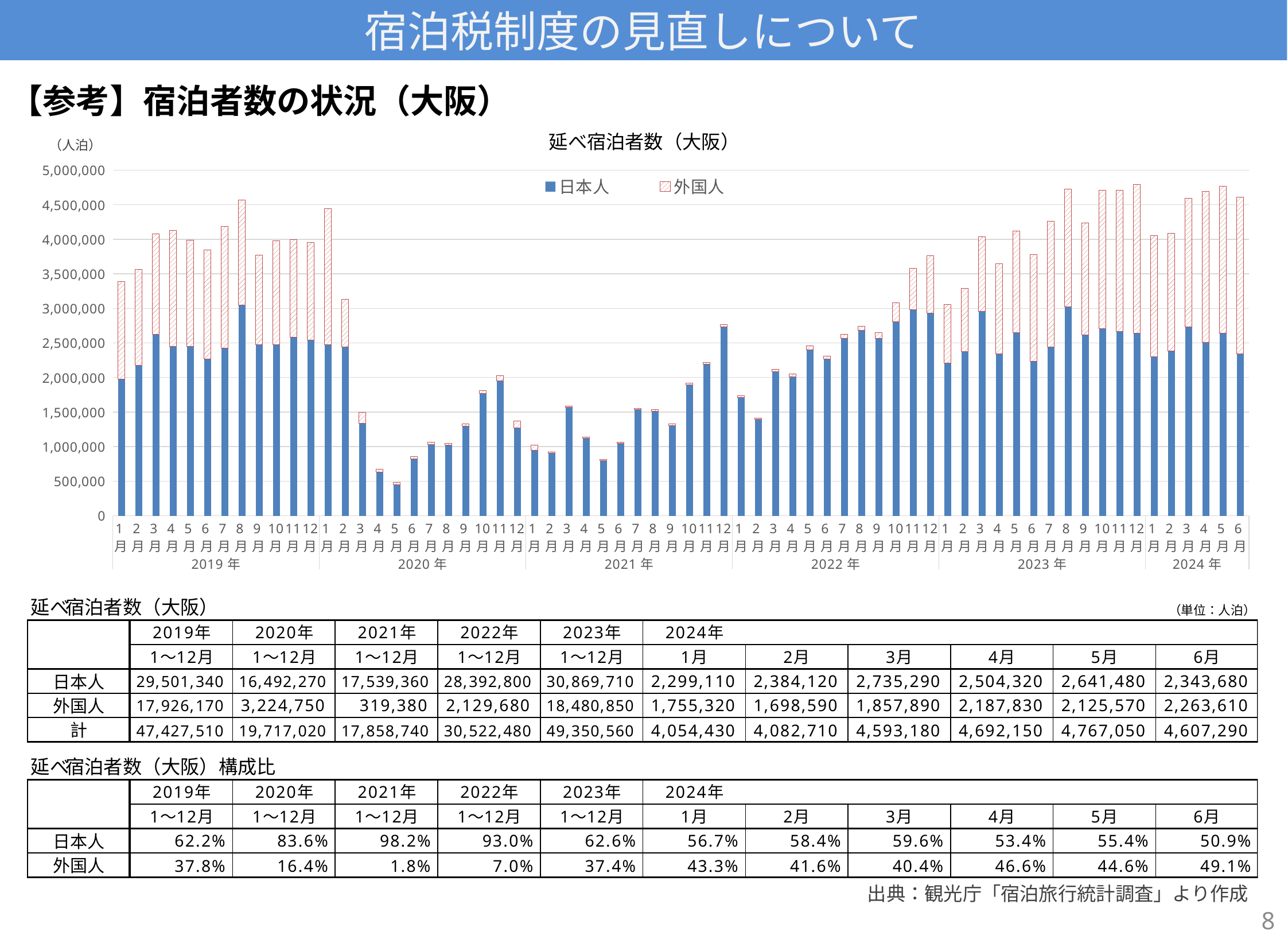
According to the slide, what is the total (計) number of 延べ宿泊者数 for 6月 2024年? 4,607,290 Is the total bar for 8月 2023年 greater or less than 4,500,000? greater What kind of chart is shown on the slide? Stacked bar chart Which is larger, the total bar for 8月 2019年 or the total bar for 8月 2020年? 8月 2019年 Is the 日本人 value for 12月 2021年 greater or less than 2,500,000? greater What are the two series named in the chart legend? 日本人 and 外国人 Which month has the lowest total bar in the chart? 5月 2020年 How many years are labelled along the x axis of the chart? 6 What is the title of the chart? 延べ宿泊者数（大阪） How many series does the chart legend list? 2 Do the total bars rise or fall from 1月 2020年 to 5月 2020年? fall Is the total bar for 6月 2020年 greater or less than 1,000,000? less